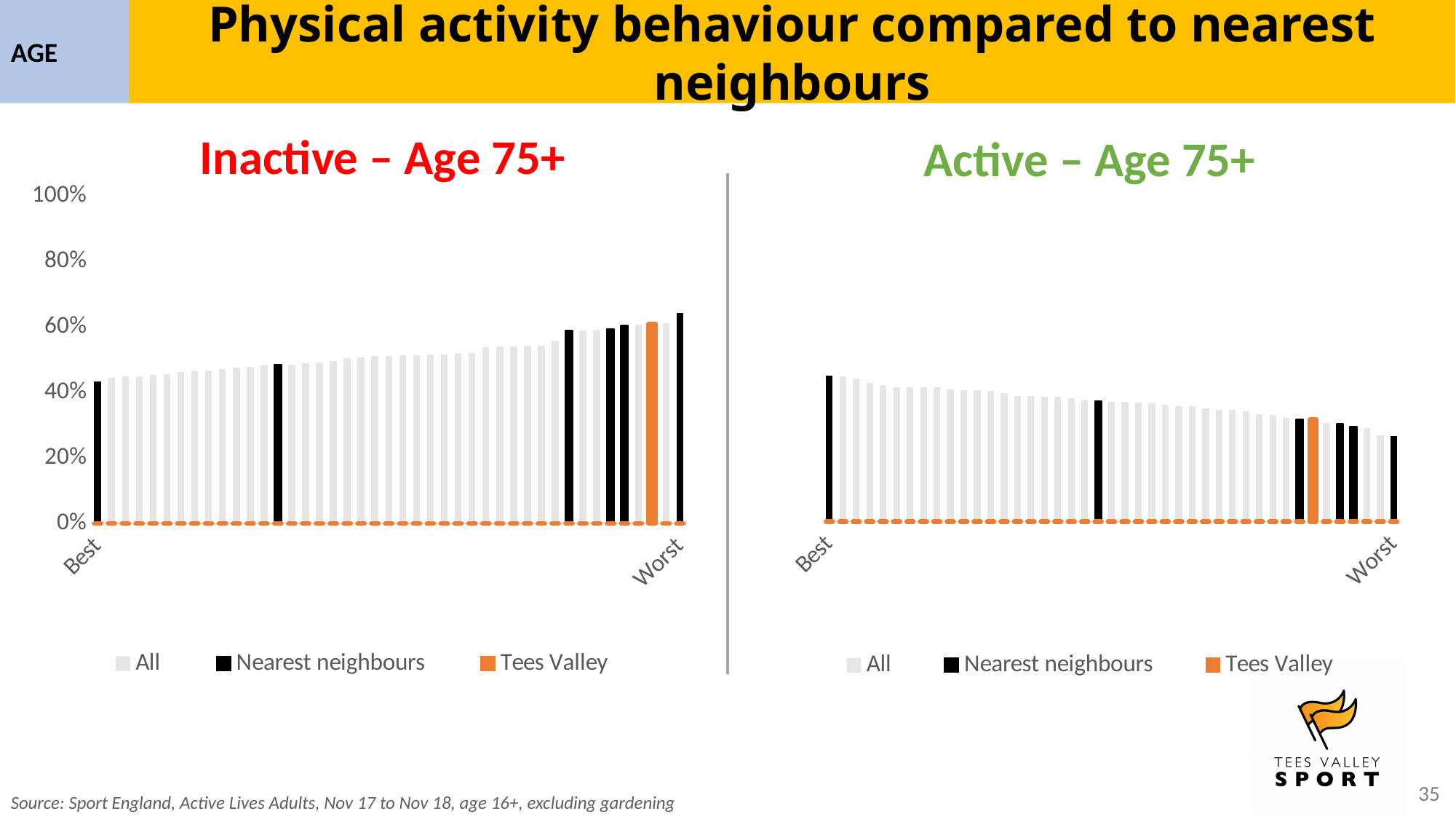
In the 'Active – Age 75+' chart, is the Tees Valley value greater or less than 20%? greater Which series is shown in orange in the 'Inactive – Age 75+' chart's legend? Tees Valley In the 'Inactive – Age 75+' chart, is the value of the Worst bar greater or less than 60%? greater In the 'Active – Age 75+' chart, is the Tees Valley value greater or less than 40%? less How many series does the legend of the 'Active – Age 75+' chart list? 3 In the 'Inactive – Age 75+' chart, do the values rise or fall from Best to Worst along the x axis? rise In the 'Active – Age 75+' chart, do the values rise or fall from Best to Worst along the x axis? fall What are the three legend entries of the 'Active – Age 75+' chart? All, Nearest neighbours, Tees Valley Is the Tees Valley value larger in the 'Inactive – Age 75+' chart or the 'Active – Age 75+' chart? Inactive – Age 75+ What kind of chart is the 'Inactive – Age 75+' chart? bar chart